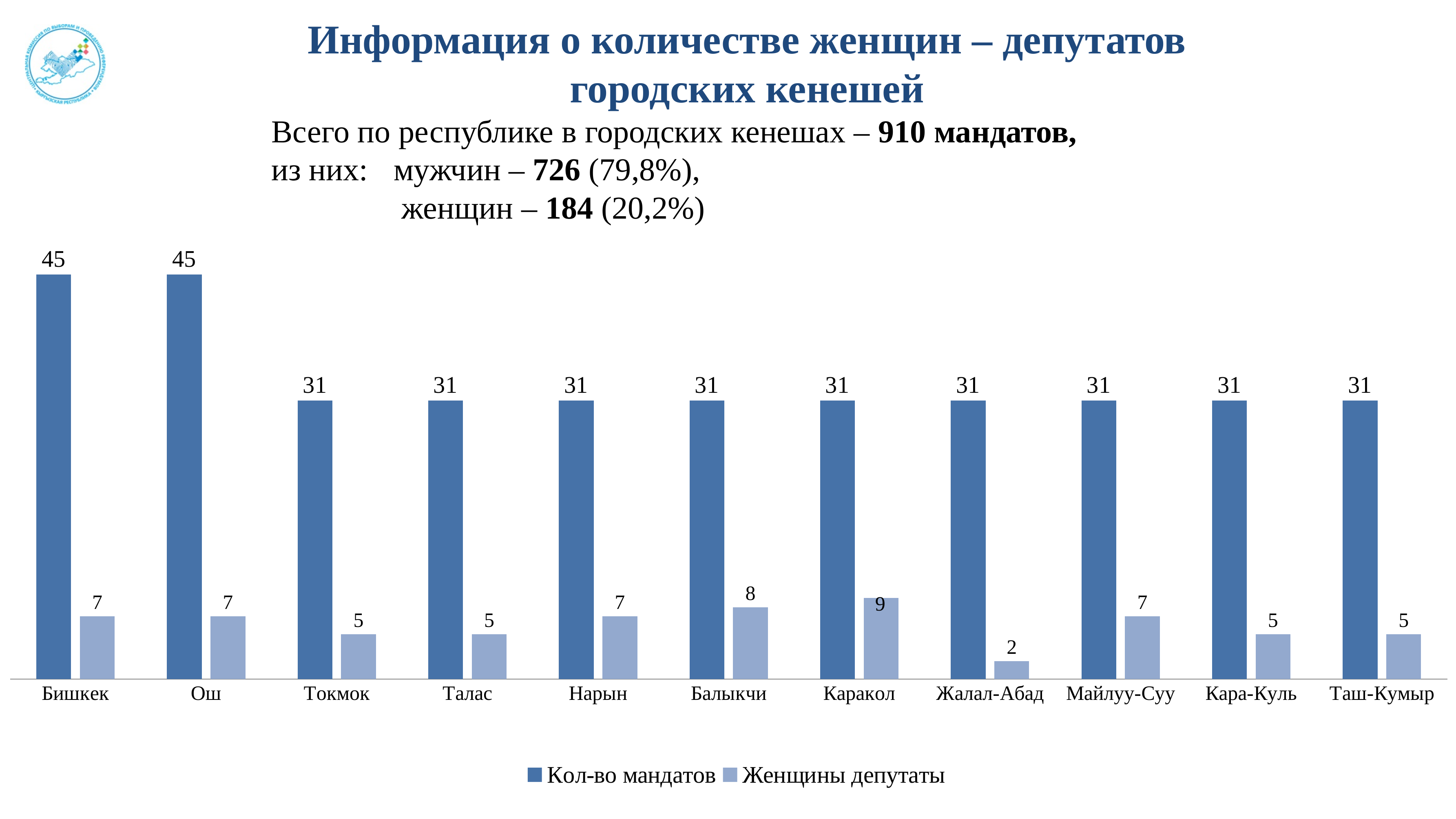
What is the value of 'Кол-во мандатов' for Таш-Кумыр? 31 How many cities are shown on the x axis of the chart? 11 How many series does the legend list? 2 Which city has the highest value for 'Женщины депутаты'? Каракол Which city has the lowest value for 'Женщины депутаты'? Жалал-Абад What is the value of 'Кол-во мандатов' for Бишкек? 45 What are the two series names listed in the legend? Кол-во мандатов, Женщины депутаты What is the value of 'Женщины депутаты' for Каракол? 9 What kind of chart is shown on the slide? bar chart Which is larger: 'Женщины депутаты' for Балыкчи or for Токмок? Балыкчи What is the difference between 'Кол-во мандатов' and 'Женщины депутаты' for Ош? 38 What is the value of 'Женщины депутаты' for Жалал-Абад? 2